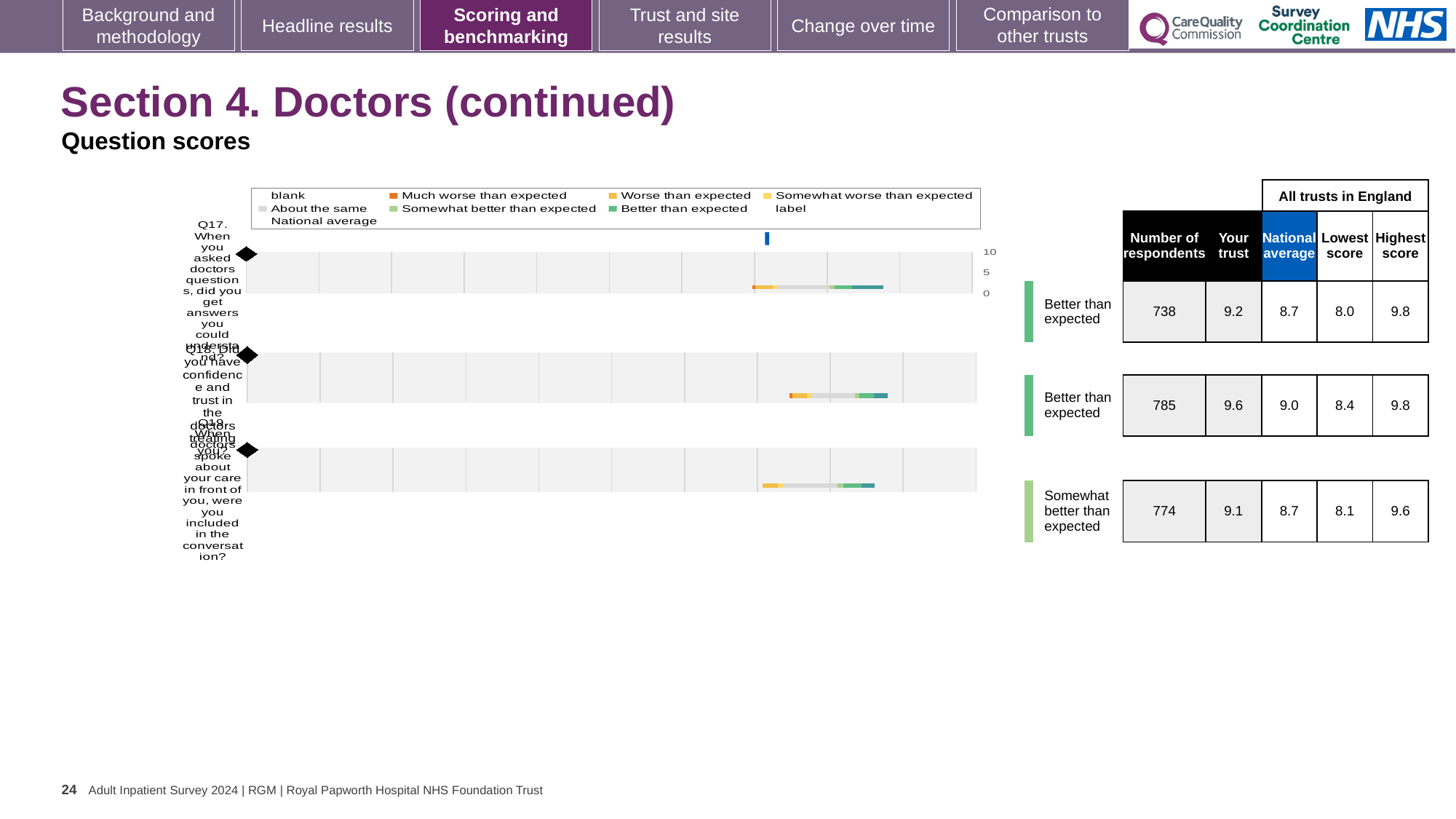
For Q17, which is larger: the 'Your trust' score or the national average? Your trust (9.2) What benchmark category is shown next to the third question row (Q19)? Somewhat better than expected For the second question row (Q18), what is the difference between the 'Your trust' score and the national average? 0.6 What is the 'Your trust' score for Q17 (When you asked doctors questions, did you get answers you could understand?)? 9.2 What is the lowest score across all trusts in England for the second question row (Q18)? 8.4 For Q17, what is the difference between the highest score and the lowest score across all trusts in England? 1.8 What is the 'Your trust' score for the second question row (Q18)? 9.6 Which of the three question rows has the lowest 'Your trust' score? Q19 (third row), 9.1 What is the national average for the third question row (Q19)? 8.7 How many question rows are plotted on this slide? 3 For Q17 (When you asked doctors questions, did you get answers you could understand?), how many respondents are shown in the table? 738 Which of the three question rows has the highest 'Your trust' score? Q18 (second row), 9.6